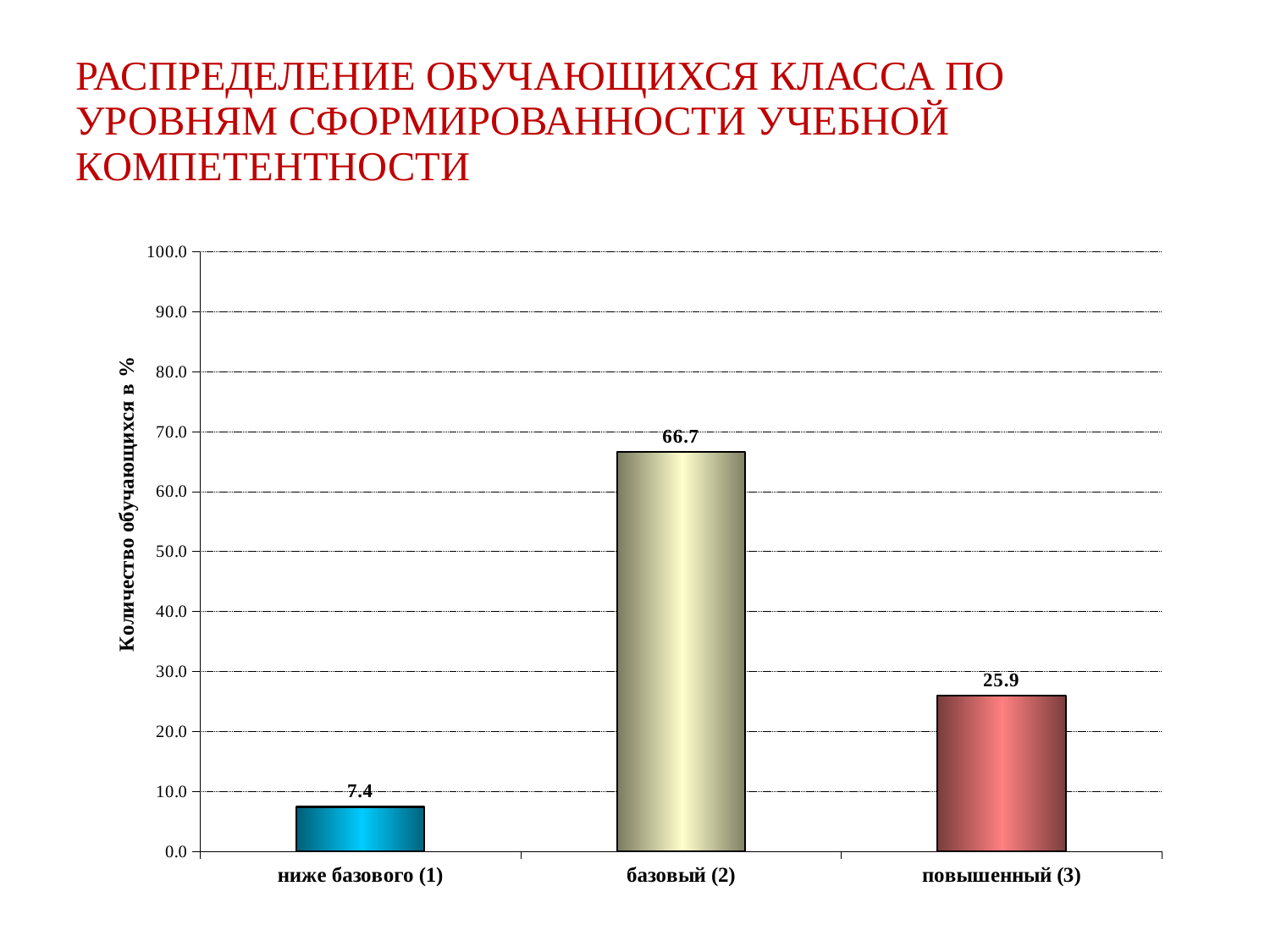
What is the difference between the values for "базовый (2)" and "повышенный (3)"? 40.8 What is the difference between the values for "повышенный (3)" and "ниже базового (1)"? 18.5 Which category has the highest value? базовый (2) What kind of chart is shown on the slide? bar chart Is the value for "базовый (2)" greater or less than 60.0? greater What is the value for "ниже базового (1)"? 7.4 What is the value for "базовый (2)"? 66.7 Which category has the lowest value? ниже базового (1) How many categories are shown on the x axis? 3 What is the value for "повышенный (3)"? 25.9 What is the label of the vertical axis? Количество обучающихся в % Which is larger, the value for "повышенный (3)" or the value for "ниже базового (1)"? повышенный (3)